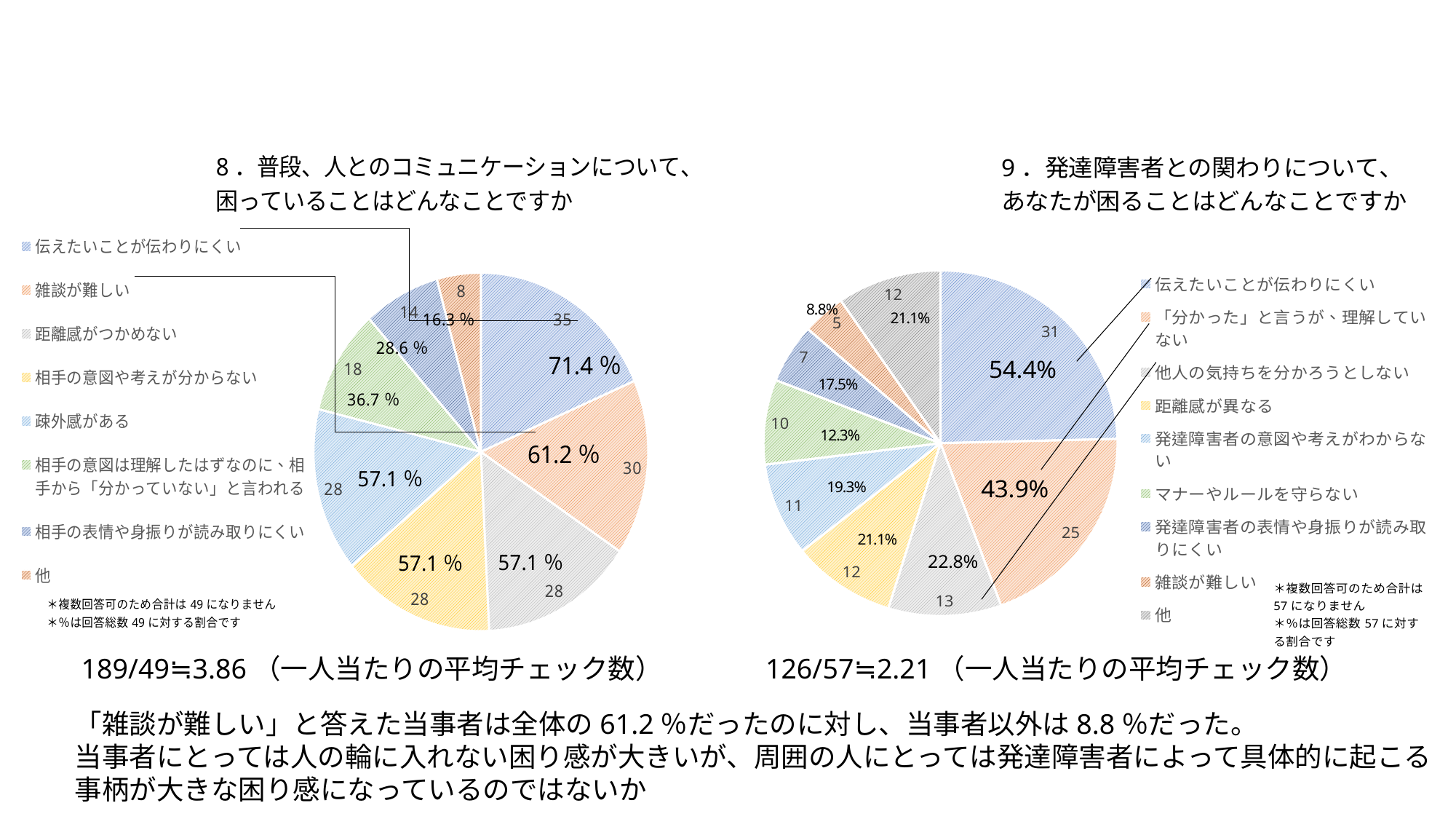
In the right pie chart (question 9), what percentage is shown for 「分かった」と言うが、理解していない? 43.9% What type of charts are shown on the slide? Pie charts In the left pie chart (question 8), what percentage is shown for 伝えたいことが伝わりにくい? 71.4 % In the left pie chart (question 8), which category has the smallest slice? 他 In the left pie chart (question 8), which category has the largest slice? 伝えたいことが伝わりにくい How many entries does the legend of the right pie chart (question 9) list? 9 How many entries does the legend of the left pie chart (question 8) list? 8 In the left pie chart (question 8), what is the difference in responses between 伝えたいことが伝わりにくい (35) and 相手の表情や身振りが読み取りにくい (14)? 21 In the right pie chart (question 9), which is larger: 他人の気持ちを分かろうとしない or 距離感が異なる? 他人の気持ちを分かろうとしない In the right pie chart (question 9), which category has the largest slice? 伝えたいことが伝わりにくい In the left pie chart (question 8), how many responses are shown for 雑談が難しい? 30 In the right pie chart (question 9), how many responses are shown for 雑談が難しい? 5